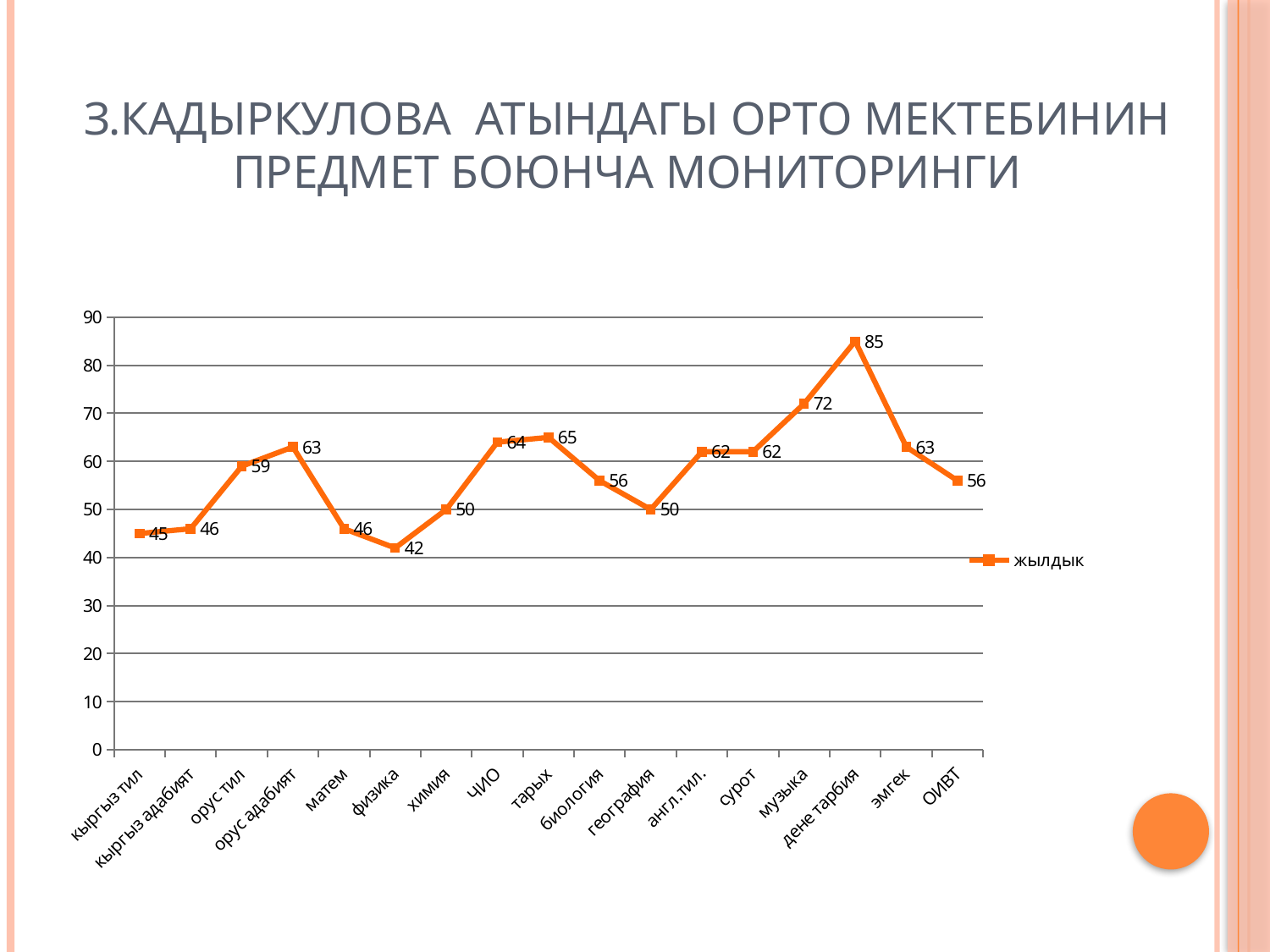
How many categories are shown on the x axis? 17 How many series does the legend list? 1 What is the difference between the values for дене тарбия and музыка? 13 What is the value for тарых? 65 What is the name of the series in the legend? жылдык What is the value for физика? 42 What kind of chart is shown on the slide? line chart What is the value for дене тарбия? 85 Which is larger, the value for орус тил or the value for матем? орус тил Which category has the lowest value? физика Is the value for музыка greater or less than 70? greater Which category has the highest value? дене тарбия